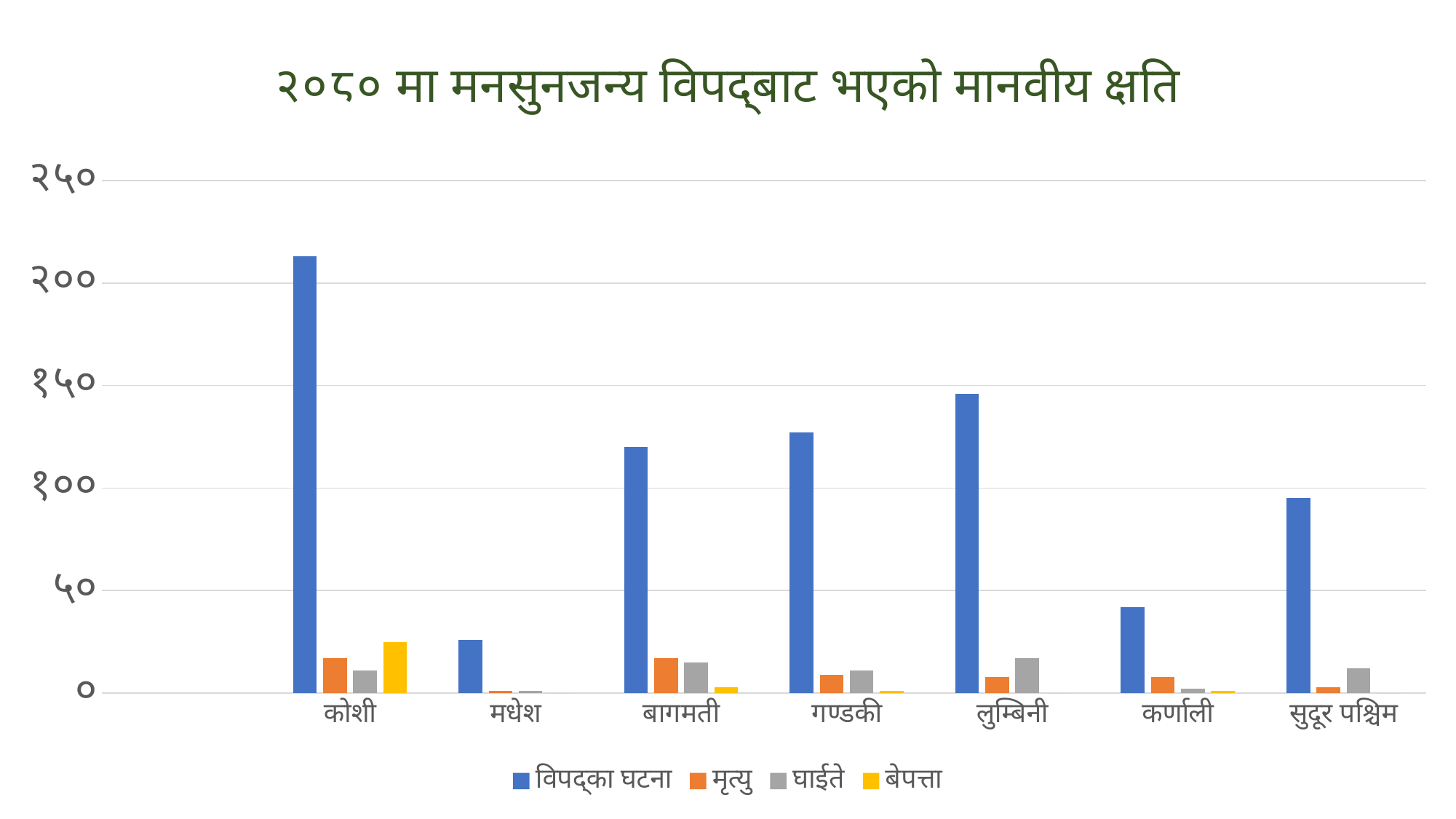
What kind of chart is shown on the slide? bar chart Which category has the highest value for बेपत्ता? कोशी Is the value for विपद्का घटना in सुदूर पश्चिम greater or less than १००? less How many series does the legend list? 4 Which category has the highest value for विपद्का घटना? कोशी Which is larger, the विपद्का घटना value for लुम्बिनी or for गण्डकी? लुम्बिनी Is the value for विपद्का घटना in कर्णाली greater or less than ५०? less Is the value for विपद्का घटना in लुम्बिनी greater or less than १५०? less Which category has the lowest value for विपद्का घटना? मधेश How many categories (provinces) are shown on the x axis? 7 What is the title of the chart? २०८० मा मनसुनजन्य विपद्बाट भएको मानवीय क्षति